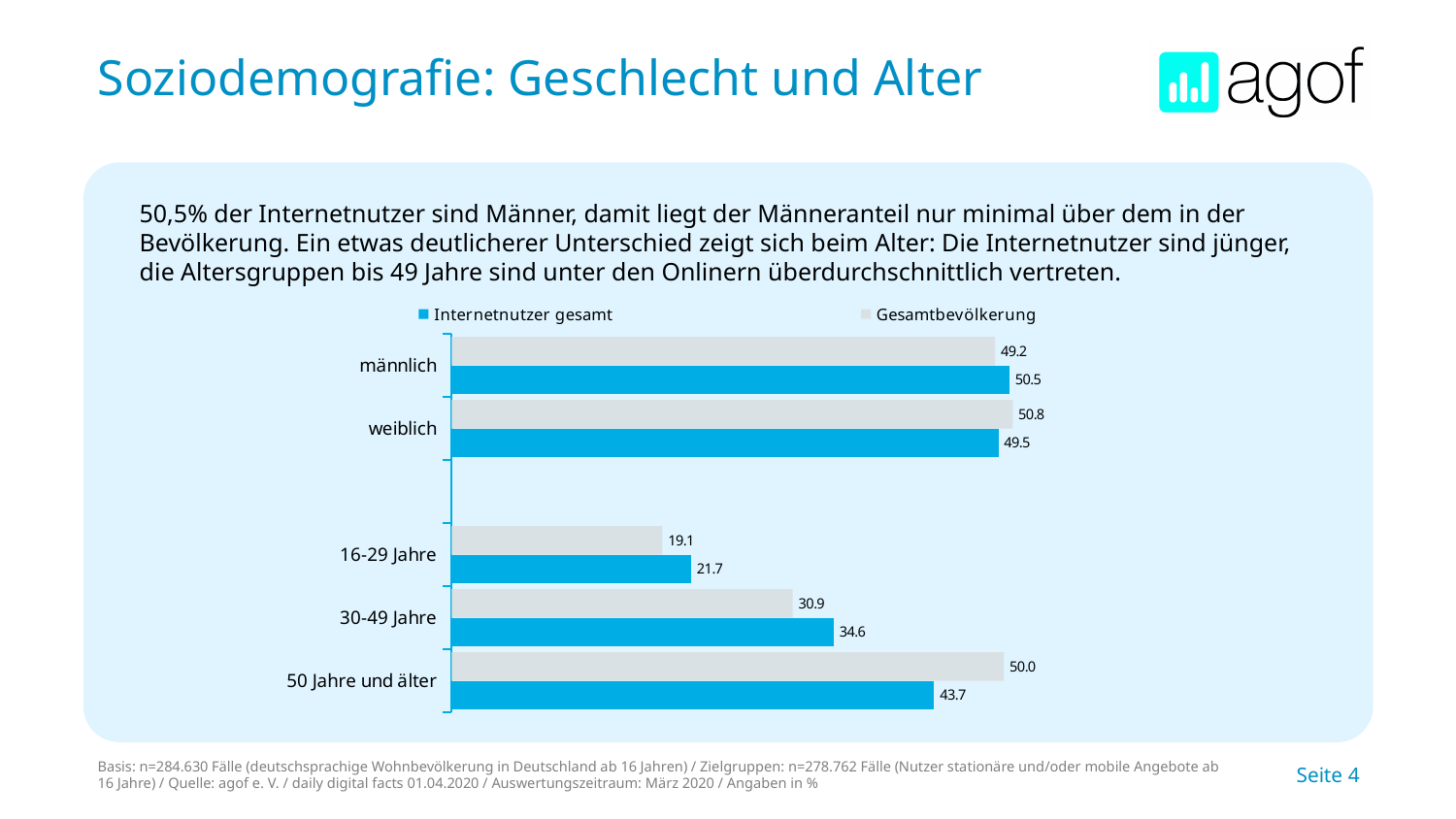
Among the age groups, which category has the highest value for Gesamtbevölkerung? 50 Jahre und älter What is the difference between Gesamtbevölkerung and Internetnutzer gesamt in the 50 Jahre und älter category? 6.3 What is the value for Internetnutzer gesamt in the männlich category? 50.5 What is the value for Gesamtbevölkerung in the 30-49 Jahre category? 30.9 In the 16-29 Jahre category, which series has the larger value: Internetnutzer gesamt or Gesamtbevölkerung? Internetnutzer gesamt What is the value for Internetnutzer gesamt in the 50 Jahre und älter category? 43.7 Among the age groups, which category has the lowest value for Internetnutzer gesamt? 16-29 Jahre How many series does the legend list? 2 What kind of chart is shown on the slide? Bar chart How many categories are shown on the chart? 5 What is the value for Gesamtbevölkerung in the 16-29 Jahre category? 19.1 What is the difference between Internetnutzer gesamt and Gesamtbevölkerung in the 30-49 Jahre category? 3.7